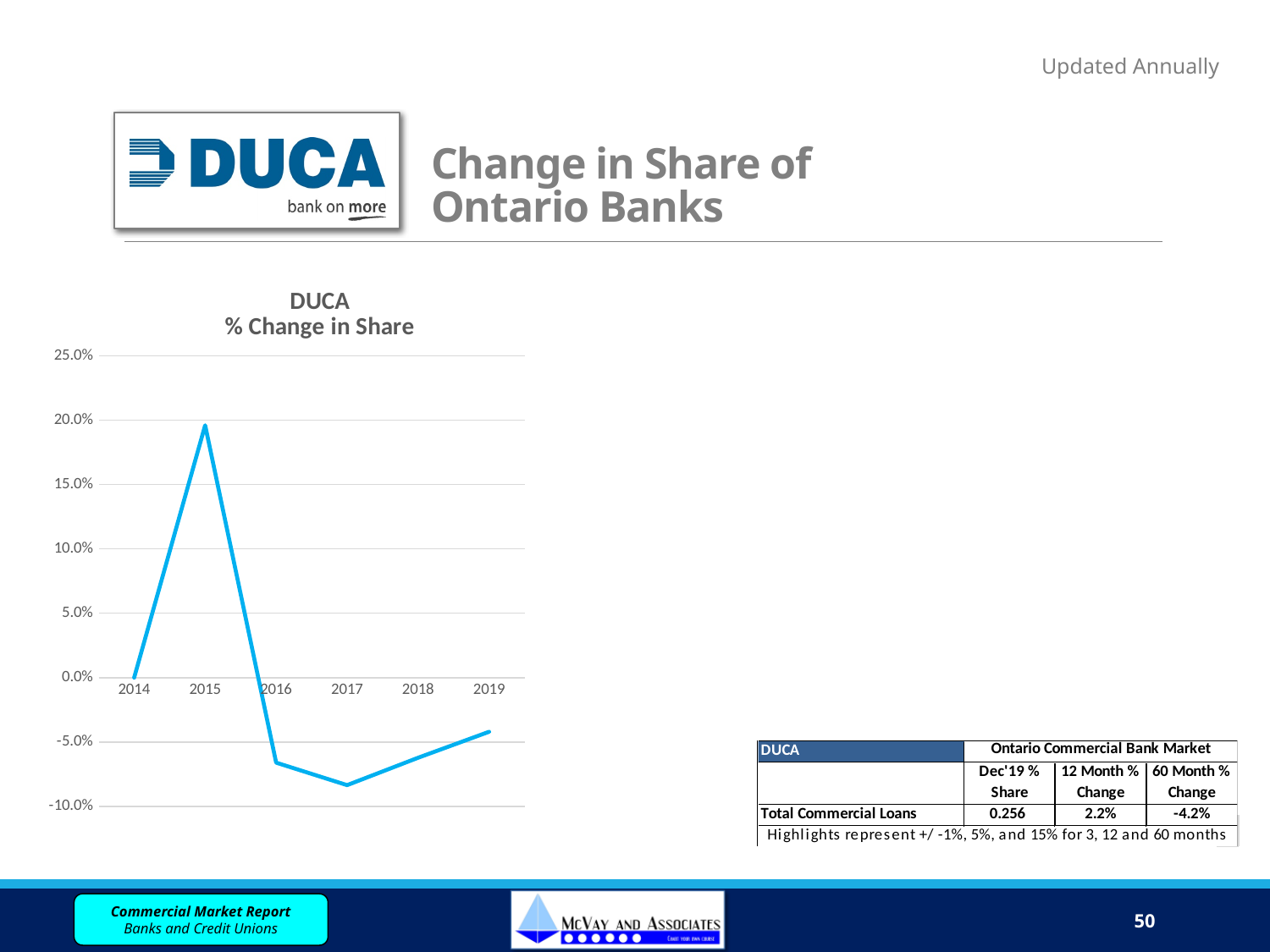
Which year has the larger % change in share, 2015 or 2016? 2015 Do the values rise or fall from 2017 to 2019 in the DUCA chart? rise Which year has the highest % change in share in the DUCA chart? 2015 Is the value for 2017 greater or less than -5.0%? less Which year has the lowest % change in share in the DUCA chart? 2017 What kind of chart is the DUCA % Change in Share chart? line chart Which year has the larger % change in share, 2019 or 2017? 2019 Is the value for 2016 greater or less than 0.0%? less What is the title of the line chart on the slide? DUCA % Change in Share How many years are plotted on the x axis of the DUCA % Change in Share chart? 6 Is the value for 2019 greater or less than -5.0%? greater